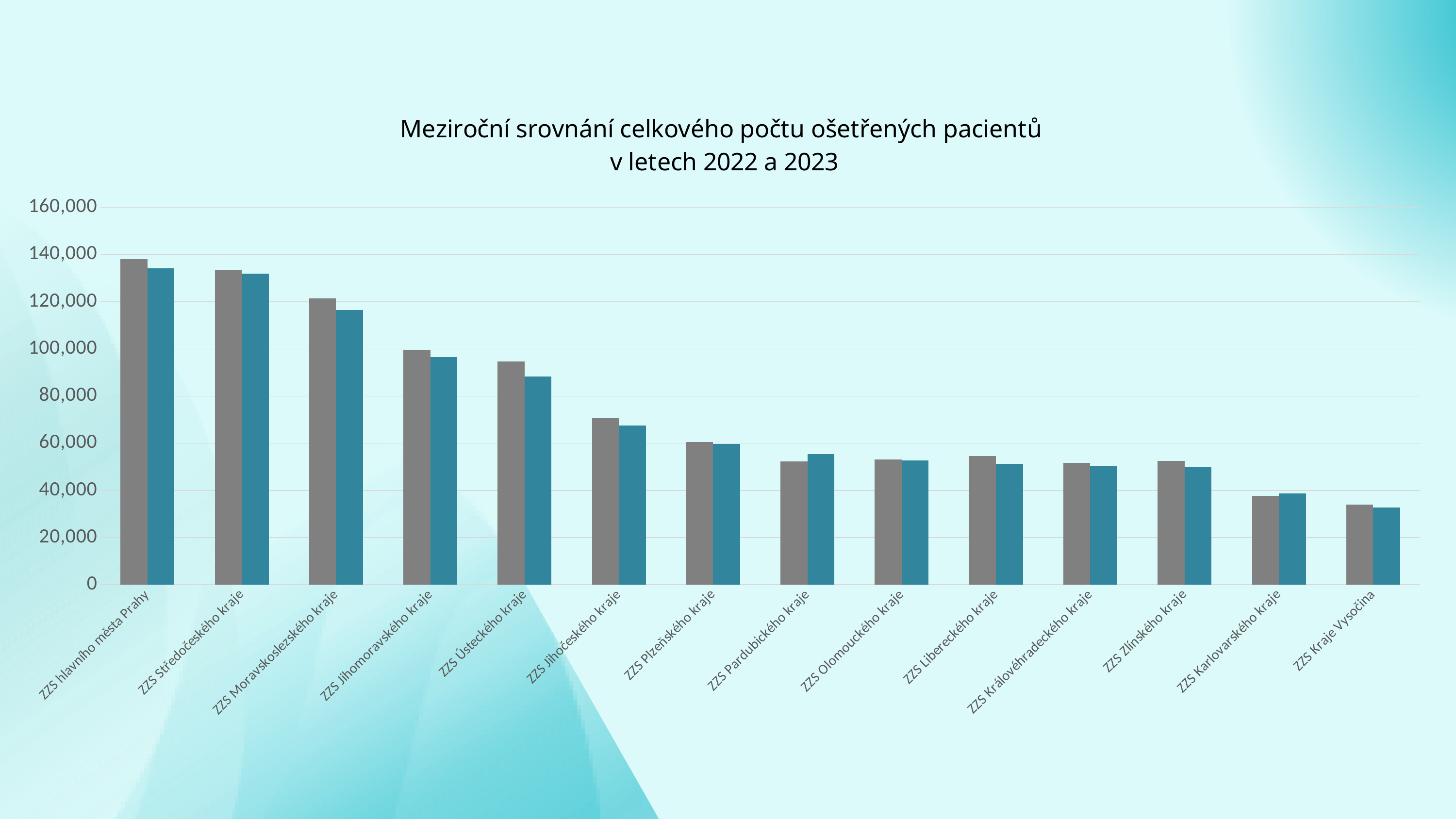
What kind of chart is shown on the slide? bar chart Which category has the lowest blue bar? ZZS Kraje Vysočina For ZZS Pardubického kraje, which bar is taller, the grey one or the blue one? the blue one Is the grey bar for ZZS Kraje Vysočina greater or less than 40,000? less Is the grey bar for ZZS hlavního města Prahy greater or less than 120,000? greater Is the blue bar for ZZS Moravskoslezského kraje greater or less than 120,000? less What is the title of the chart? Meziroční srovnání celkového počtu ošetřených pacientů v letech 2022 a 2023 Which category has the highest grey bar? ZZS hlavního města Prahy For ZZS Moravskoslezského kraje, which bar is taller, the grey one or the blue one? the grey one Do the bar heights generally rise or fall from left to right along the x axis? fall How many regional services (categories) are shown on the x axis? 14